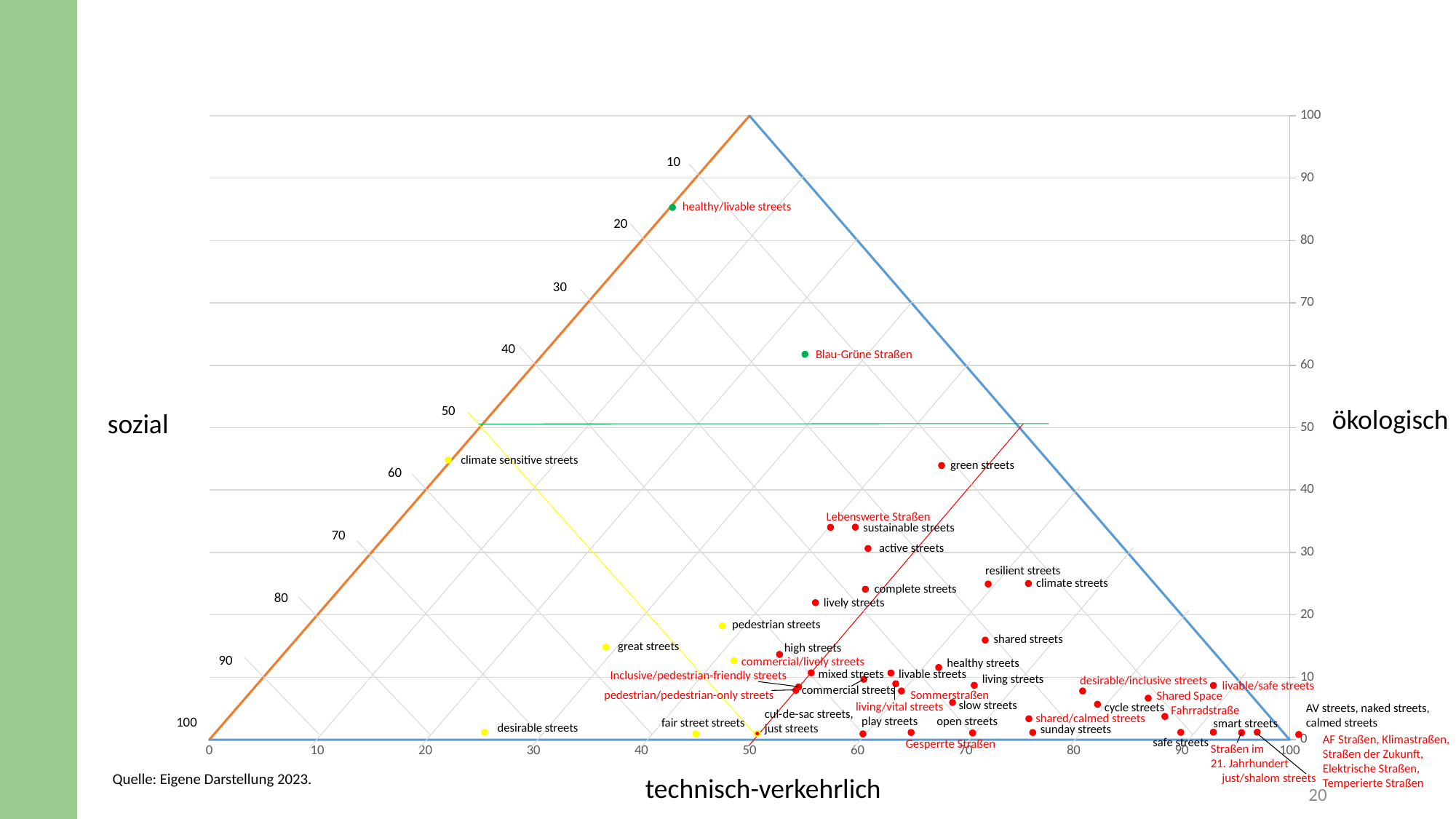
On the right-hand (ökologisch) axis, is the value for healthy/livable streets greater or less than 80? greater On the right-hand (ökologisch) axis, is the value for green streets greater or less than 50? less On the bottom (technisch-verkehrlich) axis, is the value for desirable streets greater or less than 30? less Which point lies further right on the bottom (technisch-verkehrlich) axis, green streets or climate sensitive streets? green streets Which point is higher on the right-hand (ökologisch) axis, healthy/livable streets or Blau-Grüne Straßen? healthy/livable streets Which labelled point is highest on the right-hand (ökologisch) axis? healthy/livable streets What are the three axis labels of the triangle chart? sozial, ökologisch, technisch-verkehrlich What source note is printed below the chart? Quelle: Eigene Darstellung 2023. What kind of chart is shown on the slide? ternary scatter plot